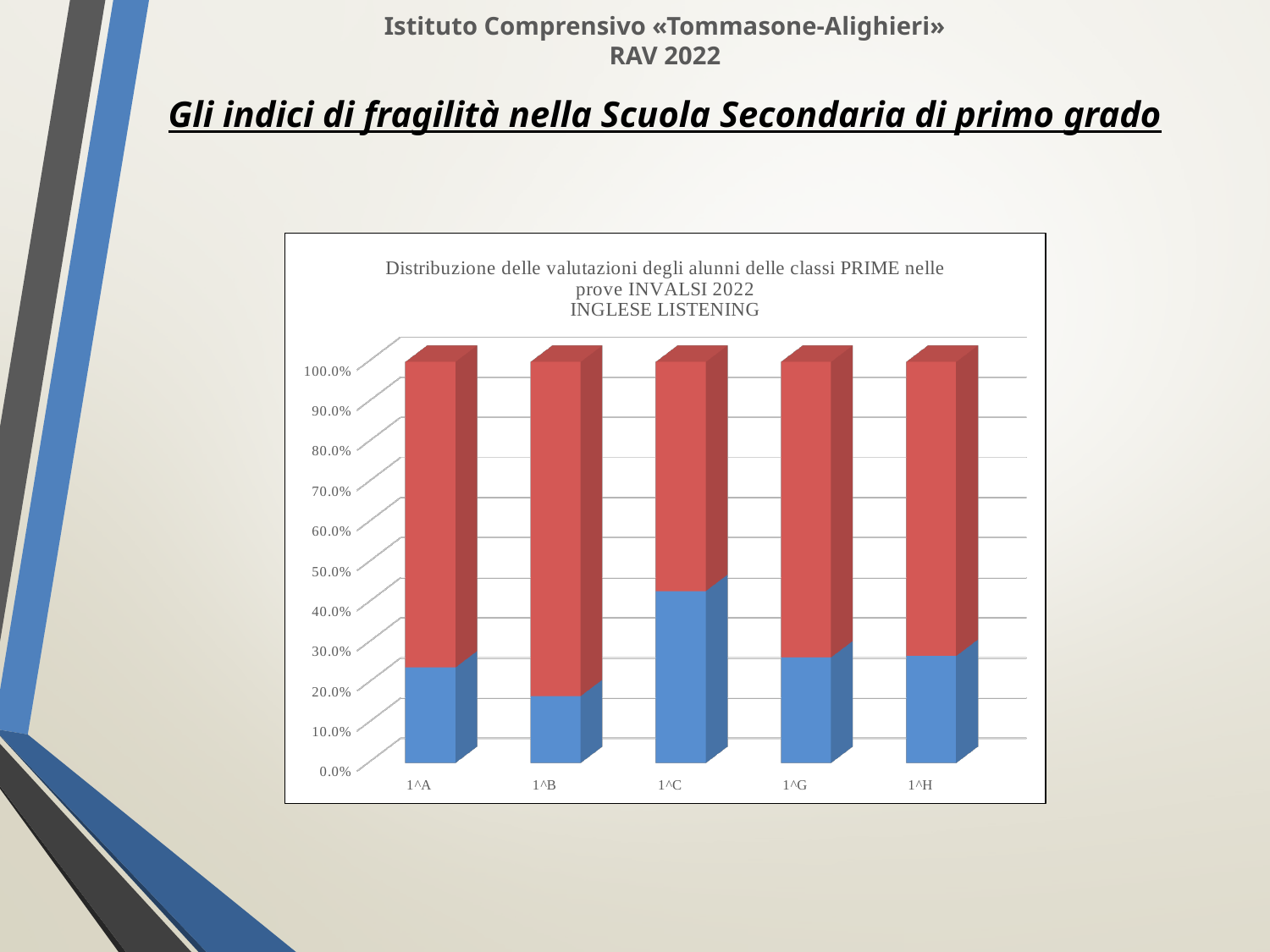
What is the title of the chart? Distribuzione delle valutazioni degli alunni delle classi PRIME nelle prove INVALSI 2022 INGLESE LISTENING What two colours are used for the segments of the stacked bars? Blue and red Is the blue segment for 1^C larger or smaller than the blue segment for 1^A? larger How many classes (categories) are shown on the x axis of the chart? 5 Is the blue segment for 1^G greater or less than 20%? greater Is the blue segment for 1^A greater or less than 30%? less Which class has the smallest blue (bottom) segment in the chart? 1^B What is the total height of the stacked bar for 1^A? 100.0% Is the blue segment for 1^C greater or less than 40%? greater Which class has the largest blue (bottom) segment in the chart? 1^C What kind of chart is shown on the slide? Stacked bar chart